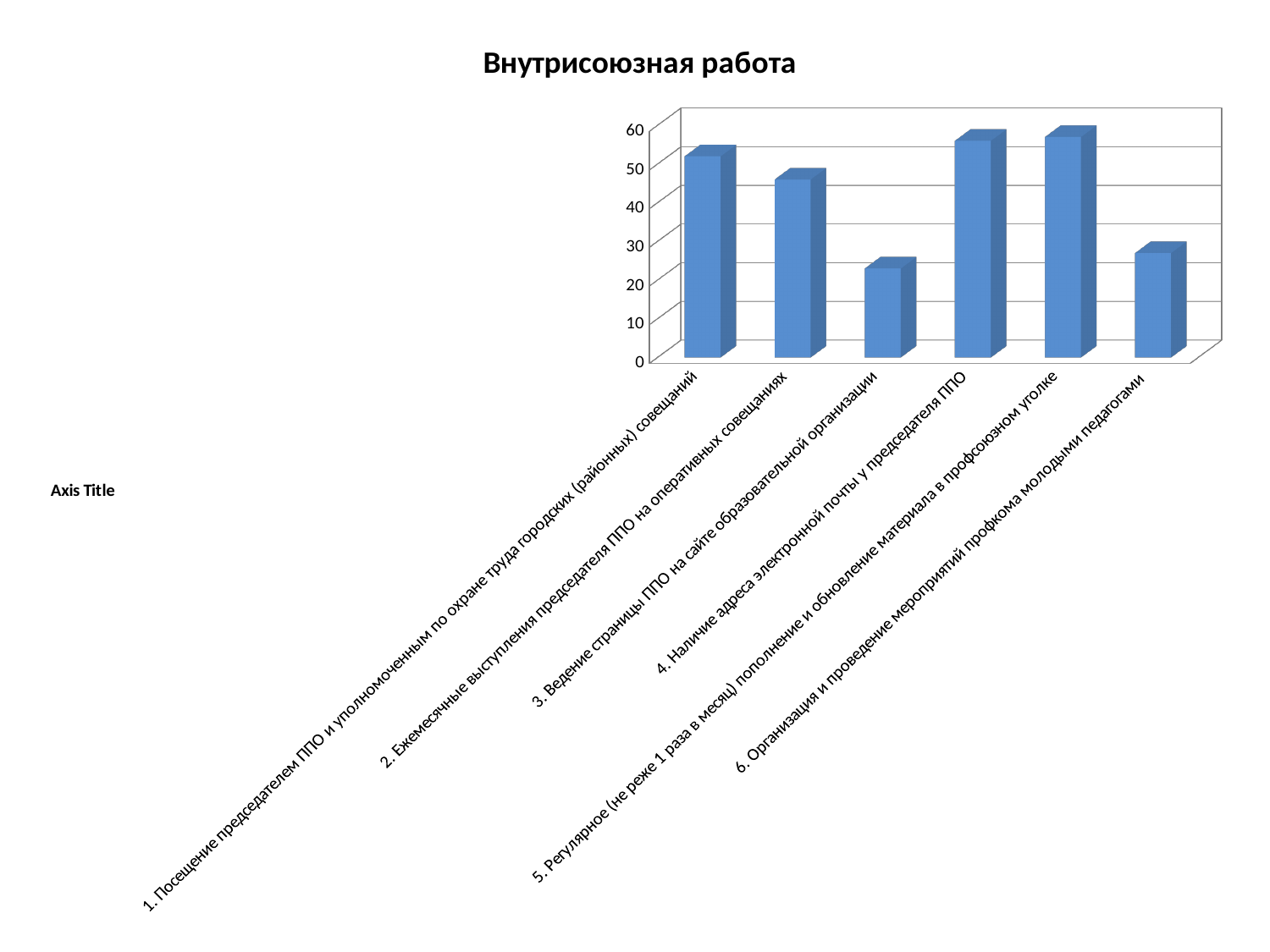
What text is shown as the axis title on the left of the slide? Axis Title Which is larger: the value for category 6 or the value for category 2? Category 2 Is the value for category 2 (Ежемесячные выступления председателя ППО на оперативных совещаниях) greater or less than 30? greater Is the value for category 6 (Организация и проведение мероприятий профкома молодыми педагогами) greater or less than 40? less Is the value for category 4 (Наличие адреса электронной почты у председателя ППО) greater or less than 50? greater Which category has the lowest value? 3. Ведение страницы ППО на сайте образовательной организации What kind of chart is shown on the slide? Bar chart What is the title of the chart? Внутрисоюзная работа How many categories are plotted in the chart? 6 Which is larger: the value for category 1 or the value for category 3? Category 1